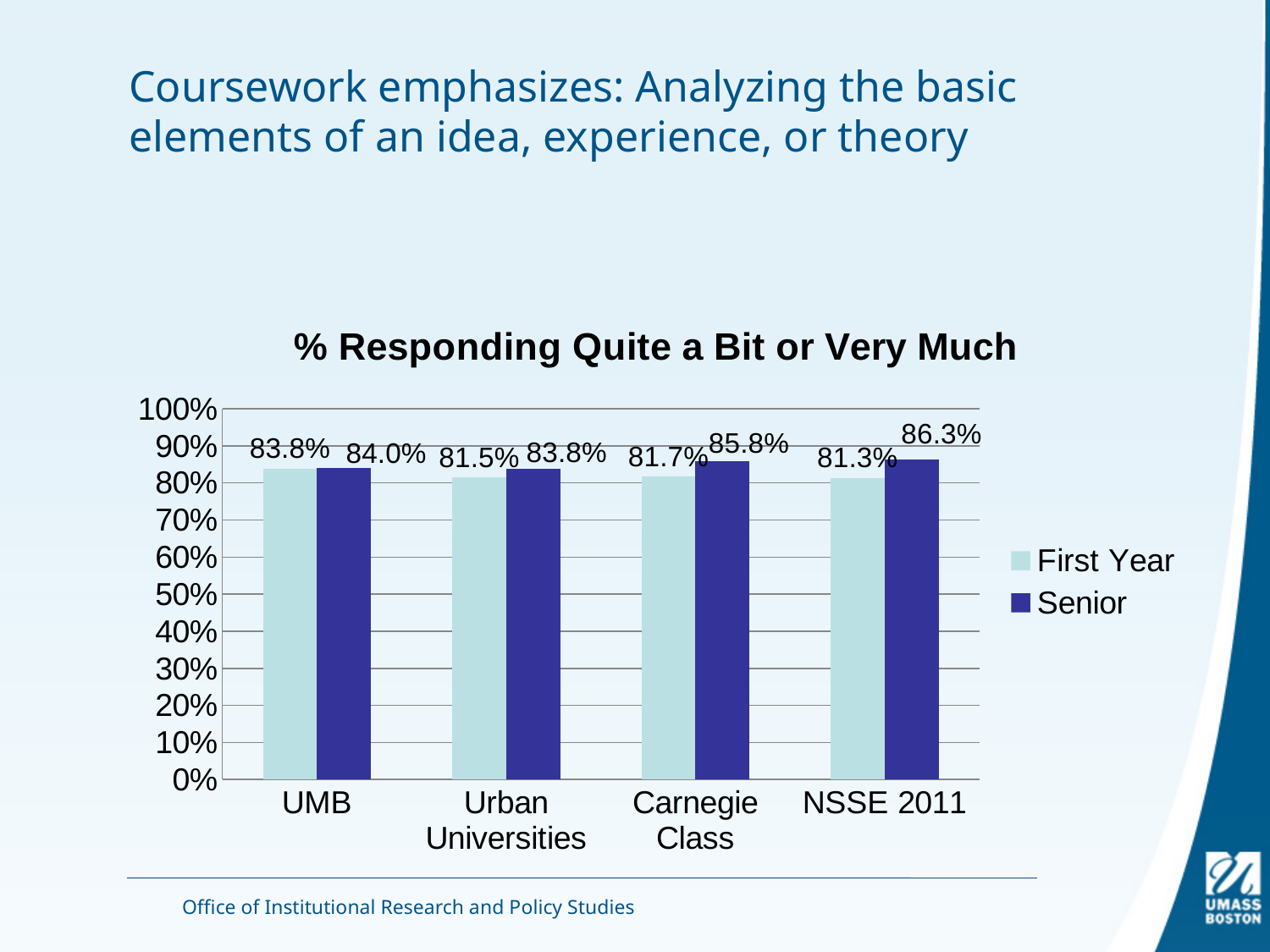
How many series does the legend list? 2 What is the difference between the Senior and First Year values for UMB? 0.2% What is the Senior value for Carnegie Class? 85.8% What is the First Year value for UMB? 83.8% What is the difference between the Senior and First Year values for NSSE 2011? 5.0% How many categories are shown on the x axis? 4 What is the First Year value for Urban Universities? 81.5% What is the Senior value for NSSE 2011? 86.3% Is the First Year value for Carnegie Class larger or smaller than the Senior value for Carnegie Class? smaller What kind of chart is shown on the slide? bar chart Which category has the highest Senior value? NSSE 2011 Which category has the highest First Year value? UMB